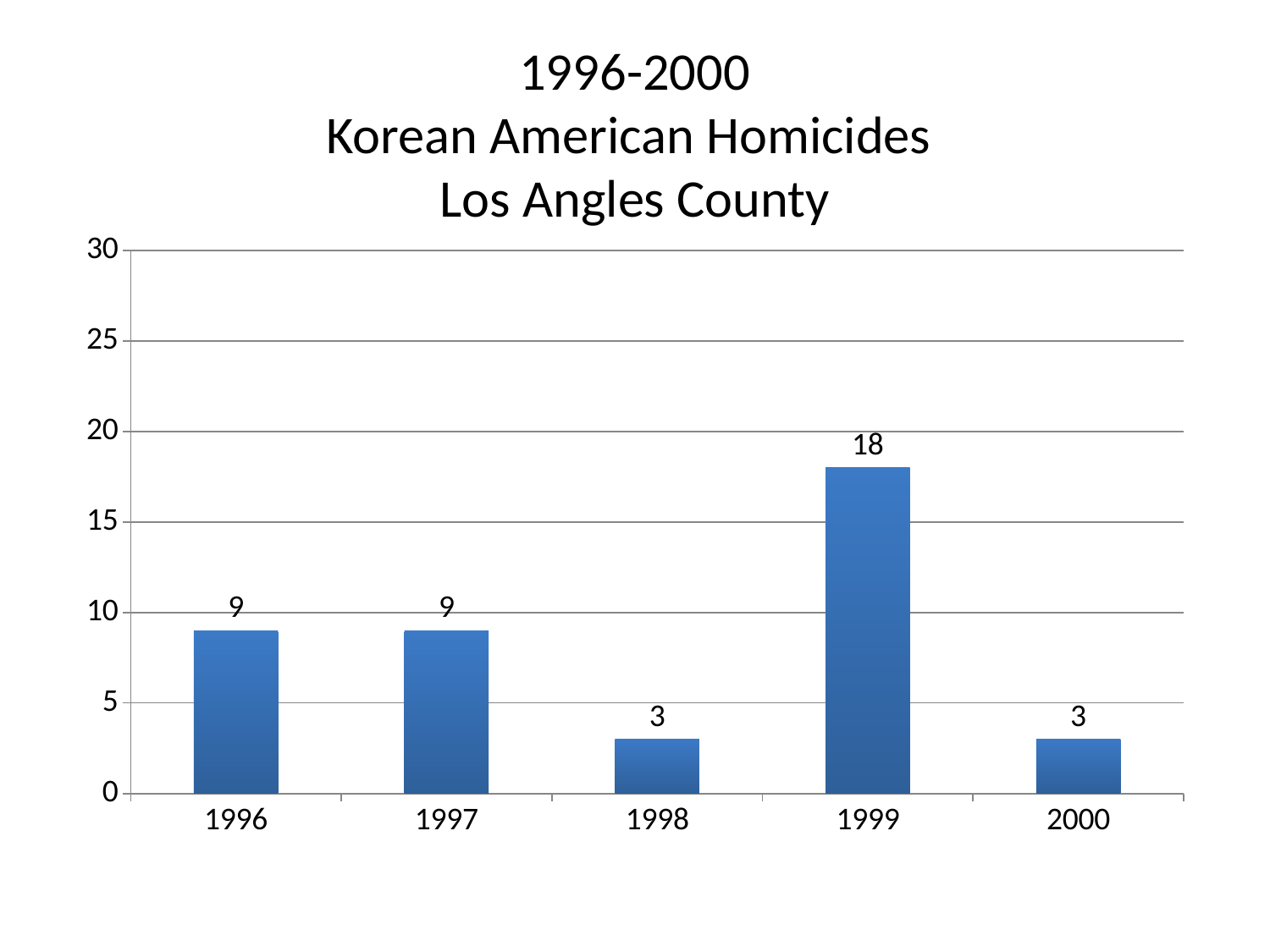
What is the value for 1999? 18 Which year has the highest value? 1999 Is the value for 2000 greater or less than 5? less What is the difference between the values for 1999 and 1997? 9 What is the value for 1996? 9 What is the value for 2000? 3 What is the difference between the values for 1996 and 1998? 6 What is the title of the chart? 1996-2000 Korean American Homicides Los Angles County Is the value for 1999 greater or less than 15? greater What kind of chart is shown on the slide? bar chart How many years are shown on the x axis? 5 Which is larger, the value for 1997 or the value for 1998? 1997